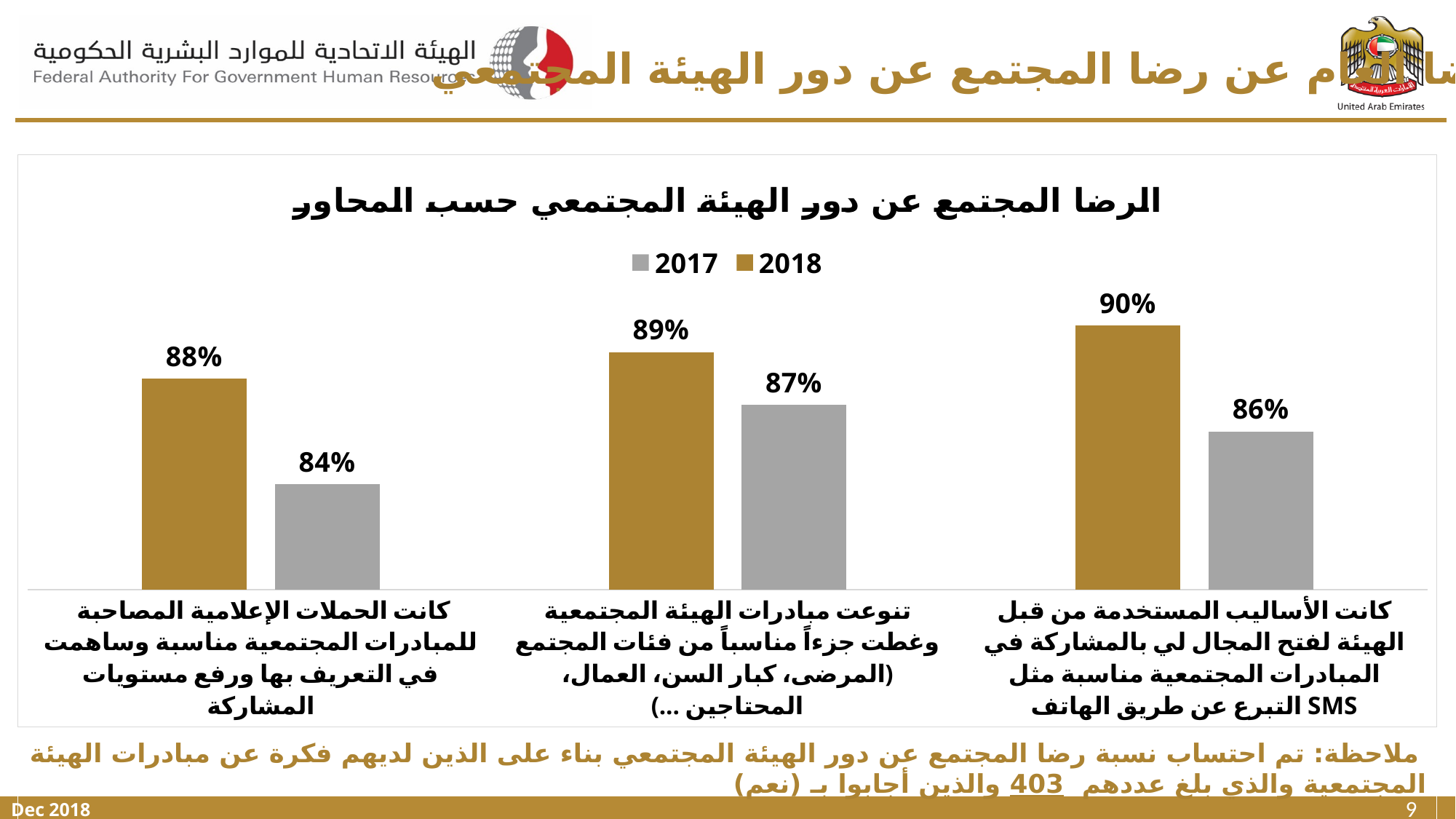
Which category has the lowest 2017 value? كانت الحملات الإعلامية المصاحبة للمبادرات المجتمعية مناسبة وساهمت في التعريف بها ورفع مستويات المشاركة Which category has the highest 2018 value? كانت الأساليب المستخدمة من قبل الهيئة لفتح المجال لي بالمشاركة في المبادرات المجتمعية مناسبة مثل التبرع عن طريق الهاتف SMS Which colour represents the 2018 series in the chart? gold What is the 2018 value for the rightmost category (the one mentioning SMS donation methods)? 90% What is the 2018 value for the leftmost category (the one about accompanying media campaigns)? 88% What type of chart is shown on the slide? bar chart What is the 2017 value for the middle category (the one about the diversity of the authority's community initiatives)? 87% For the middle category (diversity of community initiatives), which series has the larger value, 2017 or 2018? 2018 What is the difference between the 2018 and 2017 values for the leftmost category (accompanying media campaigns)? 4% How many categories are shown on the x axis of the chart? 3 What is the 2017 value for the rightmost category (the one mentioning SMS donation methods)? 86% How many series does the chart legend list? 2